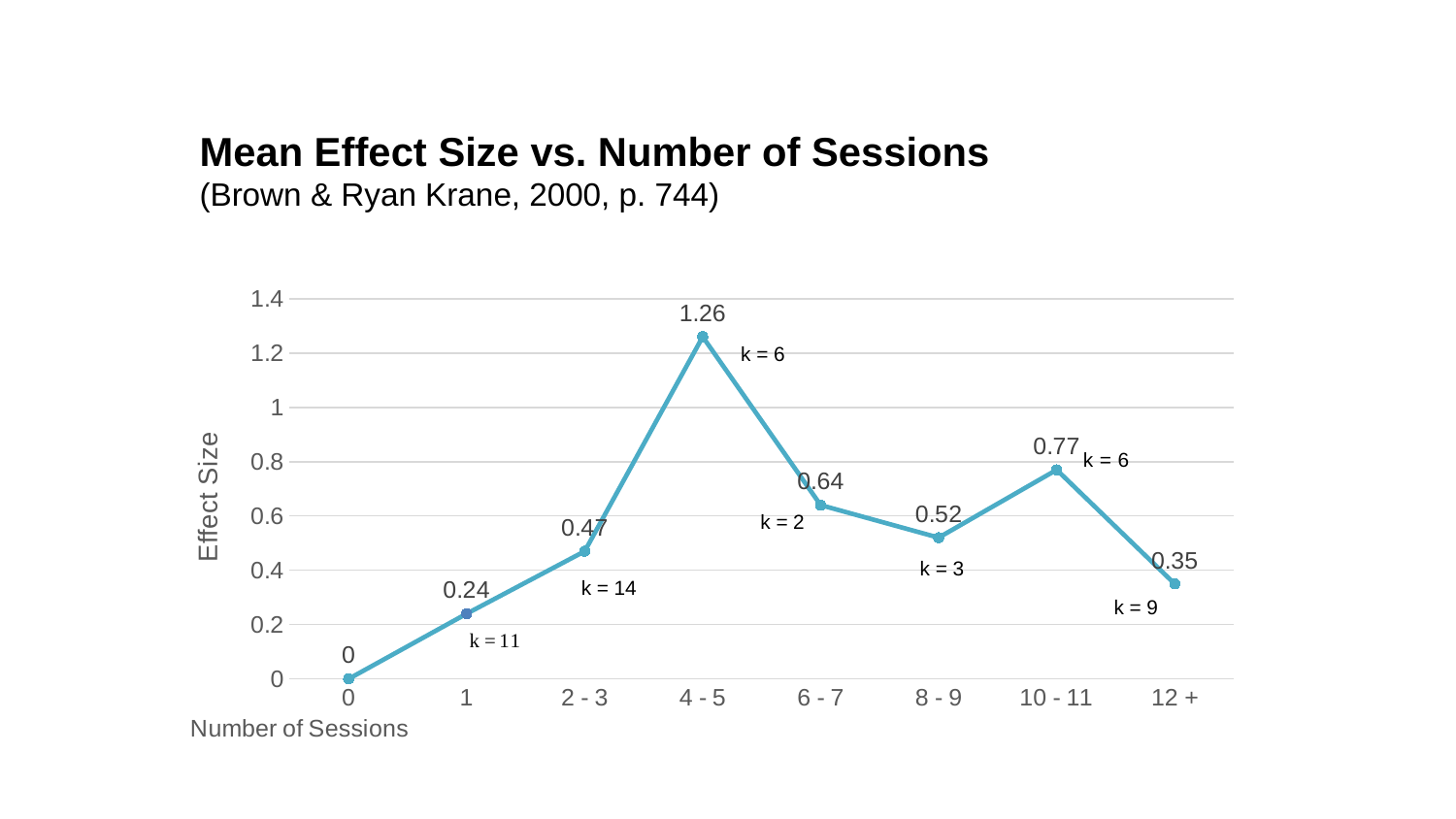
Does the effect size rise or fall from 0 sessions to 4 - 5 sessions? Rise Which number of sessions category has the lowest mean effect size? 0 What is the difference between the effect size for 4 - 5 sessions and for 6 - 7 sessions? 0.62 What kind of chart is shown on the slide? Line chart What is the title of the chart? Mean Effect Size vs. Number of Sessions What is the mean effect size for 1 session? 0.24 What is the k value shown for the 2 - 3 sessions point? k = 14 Which has a larger effect size, 10 - 11 sessions or 8 - 9 sessions? 10 - 11 What is the mean effect size for 4 - 5 sessions? 1.26 Which number of sessions category has the highest mean effect size? 4 - 5 What is the mean effect size for 12 + sessions? 0.35 How many number-of-sessions categories are plotted on the x axis? 8